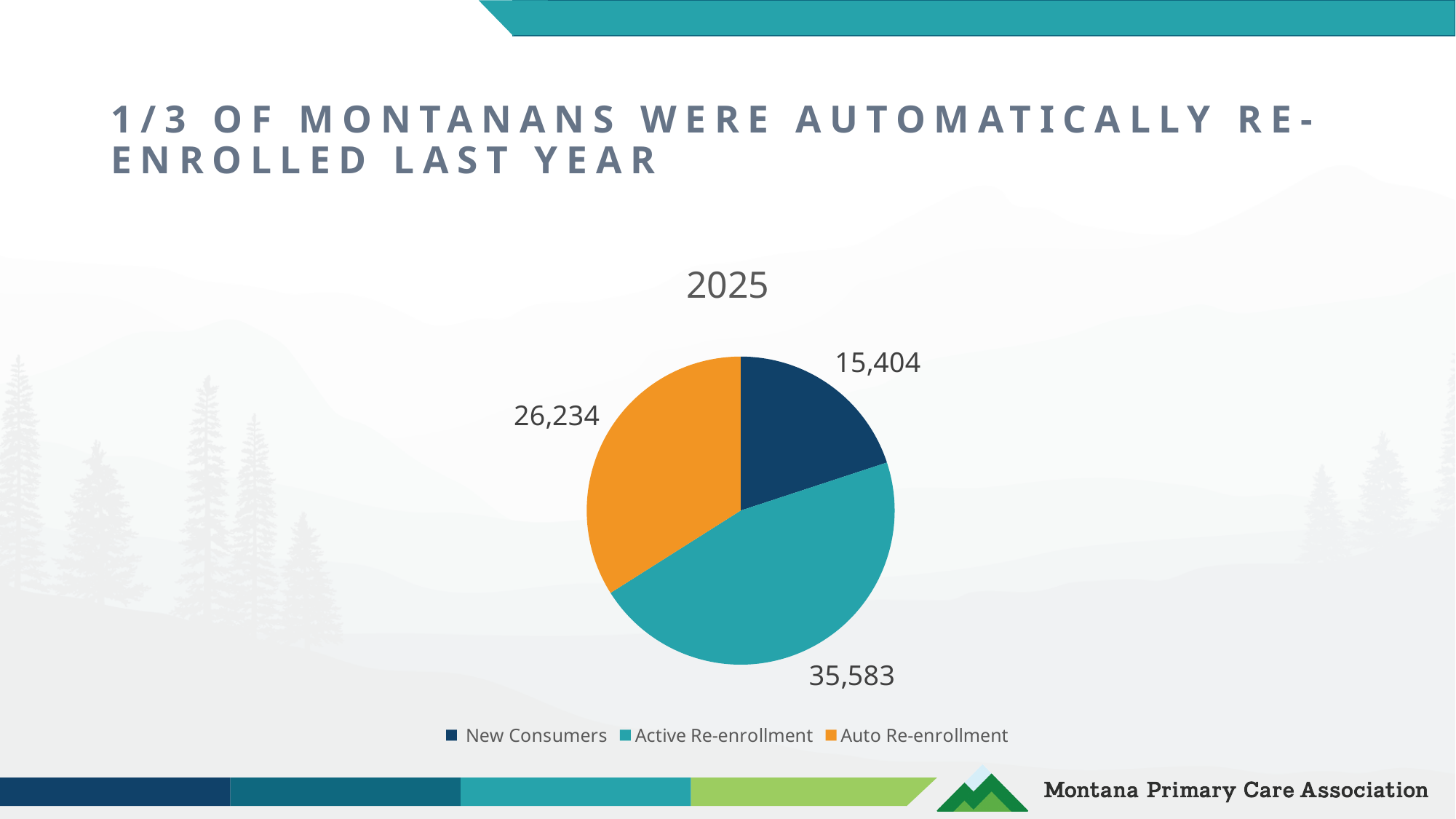
What is the total of all three slices in the pie chart? 77,221 Which category has the smallest slice of the pie? New Consumers What is the value for Active Re-enrollment? 35,583 What is the value for Auto Re-enrollment? 26,234 What is the value for New Consumers? 15,404 What is the title of the pie chart? 2025 What kind of chart is shown on the slide? Pie chart How many categories does the legend list? 3 Which category has the largest slice of the pie? Active Re-enrollment What is the difference between the Active Re-enrollment and Auto Re-enrollment values? 9,349 What is the difference between the Auto Re-enrollment and New Consumers values? 10,830 Which is larger, Auto Re-enrollment or New Consumers? Auto Re-enrollment